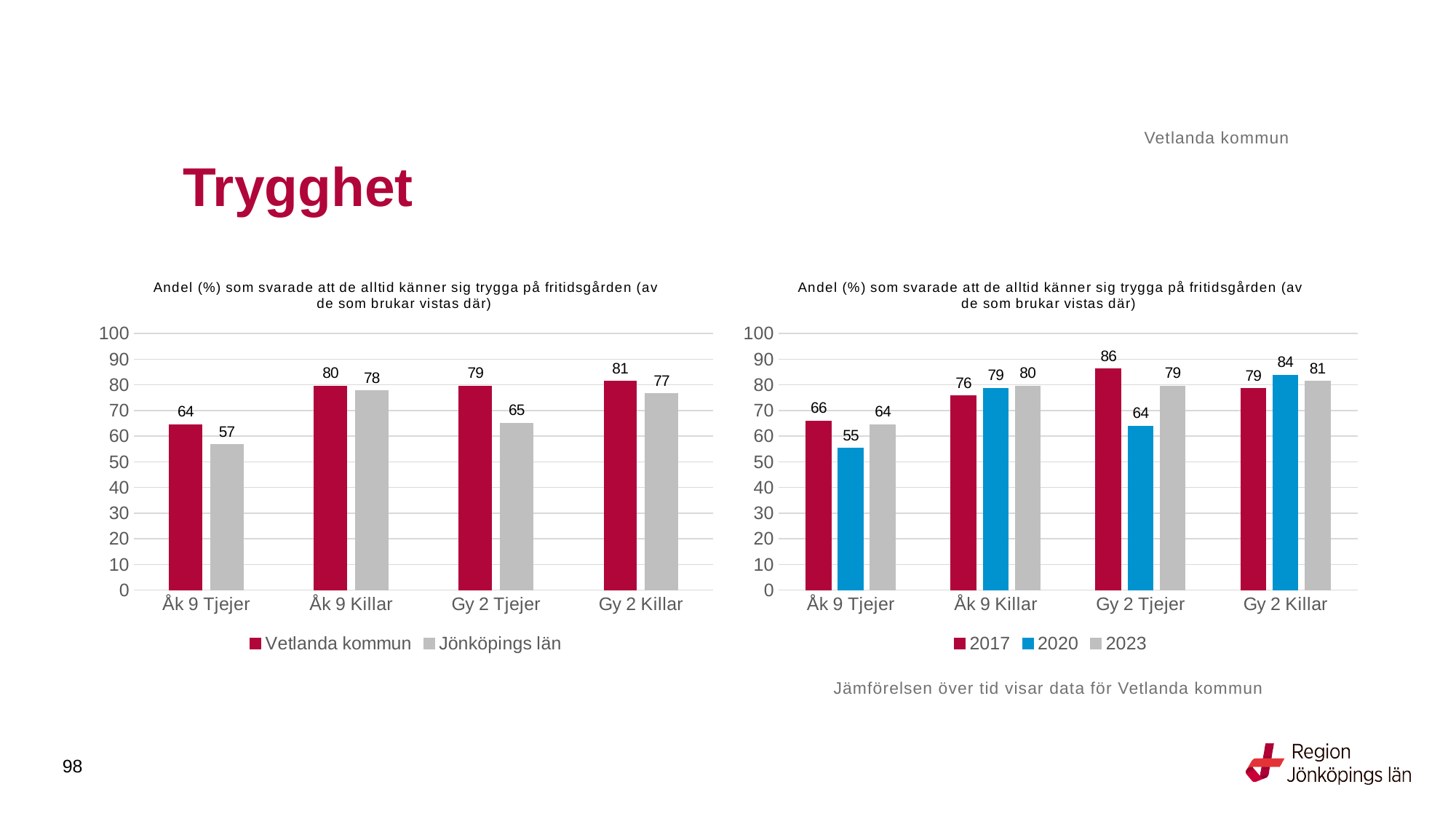
In the left chart, what is the value for Jönköpings län for Gy 2 Tjejer? 65 In the left chart, what is the difference between Vetlanda kommun and Jönköpings län for Gy 2 Tjejer? 14 In the right chart, which category has the highest value for 2020? Gy 2 Killar In the left chart, what is the value for Vetlanda kommun for Åk 9 Tjejer? 64 In the right chart, what is the difference between 2017 and 2020 for Gy 2 Tjejer? 22 In the right chart, which is larger for Gy 2 Tjejer: 2017 or 2023? 2017 In the right chart, how many categories are shown on the x axis? 4 In the right chart, what is the value for 2020 for Åk 9 Tjejer? 55 In the right chart, what is the value for 2017 for Gy 2 Tjejer? 86 In the left chart, which category has the lowest value for Jönköpings län? Åk 9 Tjejer What kind of chart is the right chart? Bar chart In the left chart, how many series does the legend list? 2